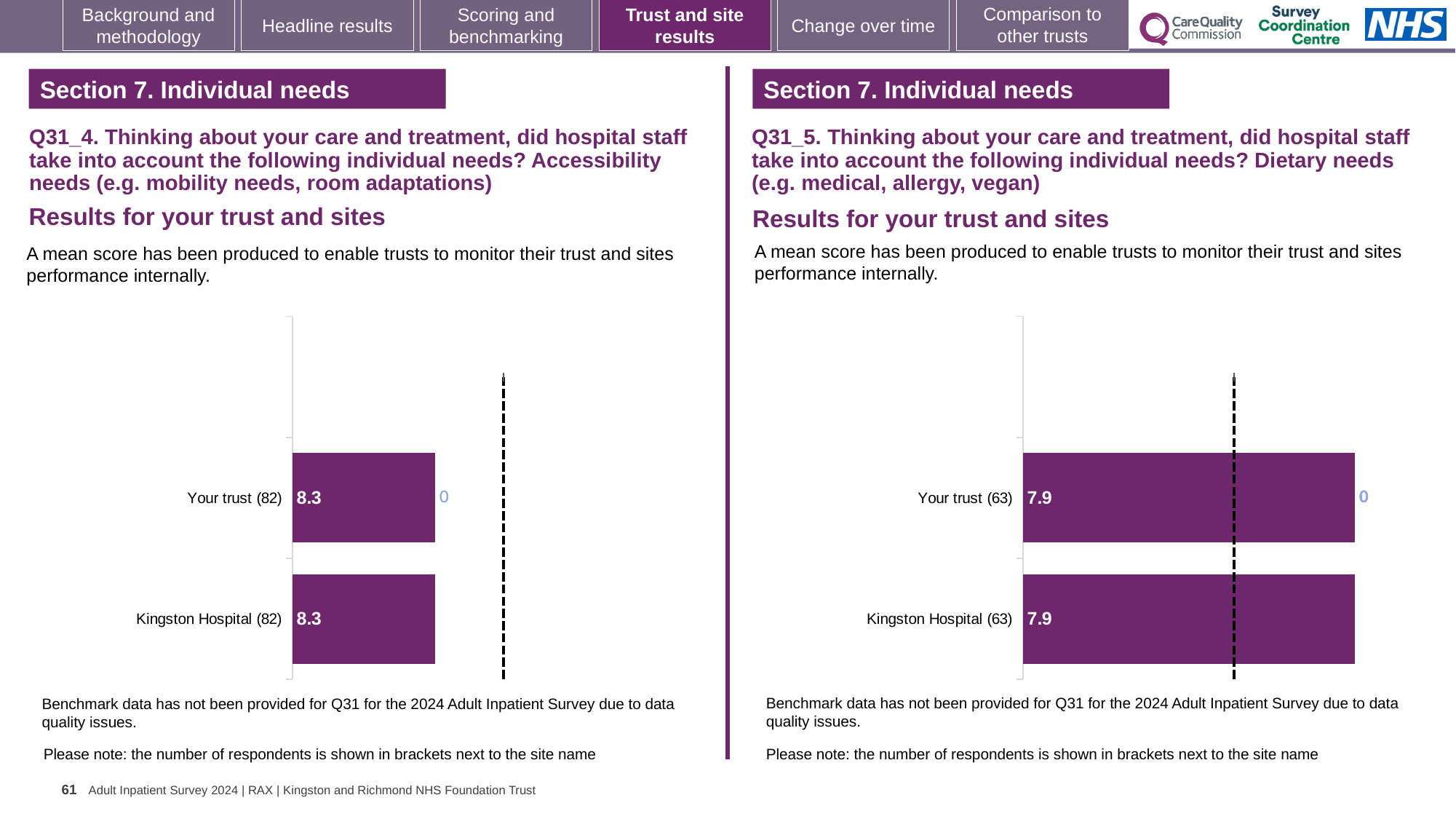
On the right chart (Q31_5), how many respondents are shown in brackets next to Kingston Hospital? 63 How many bars are plotted on the right chart (Q31_5)? 2 On the left chart (Q31_4), what is the difference between the scores for Your trust and Kingston Hospital? 0 What type of chart is used on the left (Q31_4)? Bar chart Is the Your trust score on the left chart (Q31_4) higher or lower than the Your trust score on the right chart (Q31_5)? Higher How many bars are plotted on the left chart (Q31_4)? 2 On the left chart (Q31_4), how many respondents are shown in brackets next to Your trust? 82 On the right chart (Q31_5), what is the difference between the scores for Your trust and Kingston Hospital? 0 On the right chart (Q31_5, dietary needs), what is the mean score for Kingston Hospital? 7.9 On the left chart (Q31_4, accessibility needs), what is the mean score for Kingston Hospital? 8.3 On the left chart (Q31_4, accessibility needs), what is the mean score for Your trust? 8.3 On the right chart (Q31_5, dietary needs), what is the mean score for Your trust? 7.9